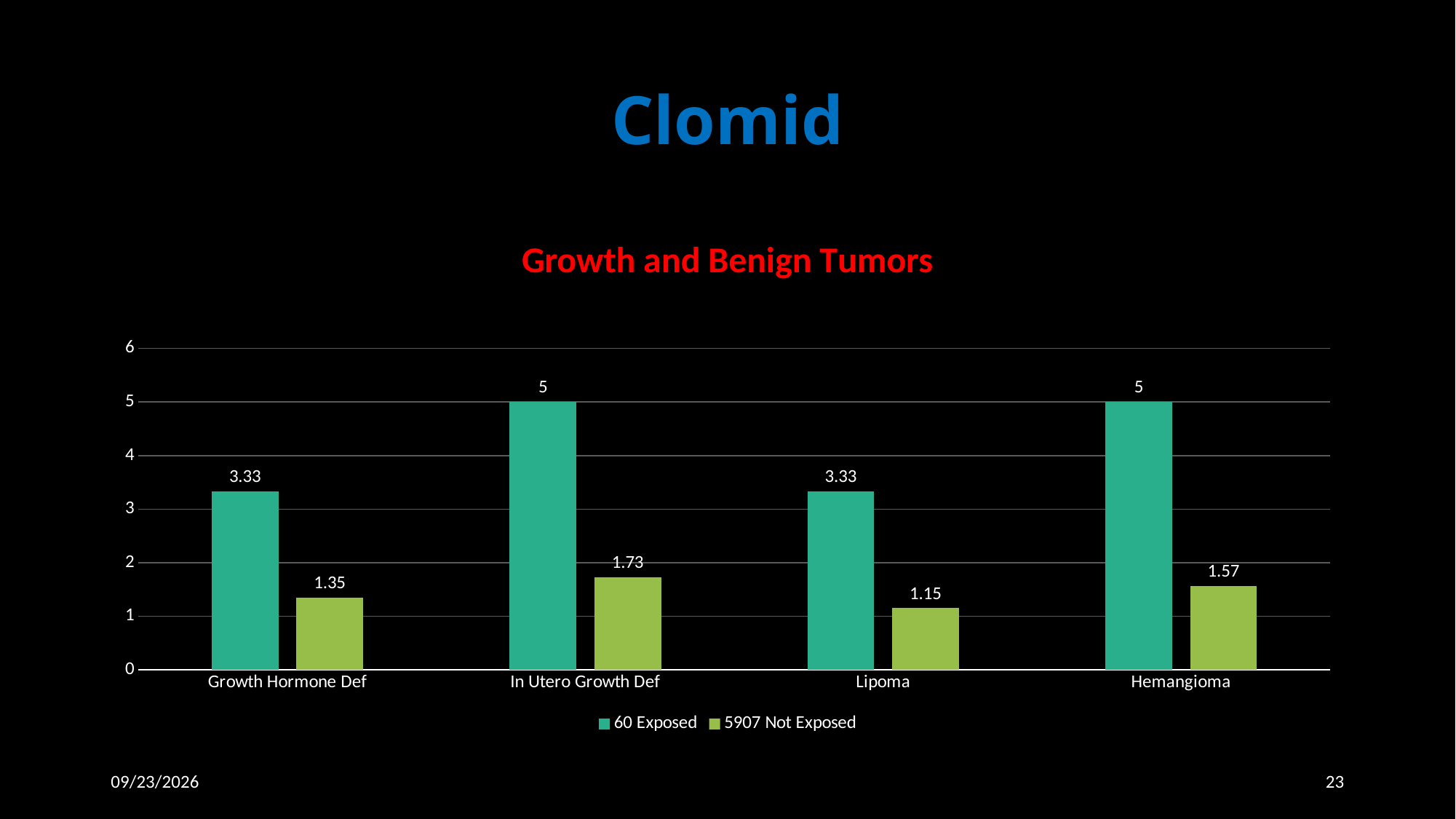
Which category has the lowest value for 5907 Not Exposed? Lipoma Which category has the highest value for 5907 Not Exposed? In Utero Growth Def What is the value for 5907 Not Exposed in the In Utero Growth Def category? 1.73 What is the difference between the 60 Exposed and 5907 Not Exposed values for Hemangioma? 3.43 What type of chart is shown on the slide? Bar chart What is the value for 5907 Not Exposed in the Hemangioma category? 1.57 What is the value for 60 Exposed in the Lipoma category? 3.33 Which is larger: the 5907 Not Exposed value for Growth Hormone Def or for Lipoma? Growth Hormone Def How many categories are shown on the x axis? 4 What is the difference between the 60 Exposed and 5907 Not Exposed values for Growth Hormone Def? 1.98 How many series does the legend list? 2 Is the value for 60 Exposed in the In Utero Growth Def category greater or less than 4? greater